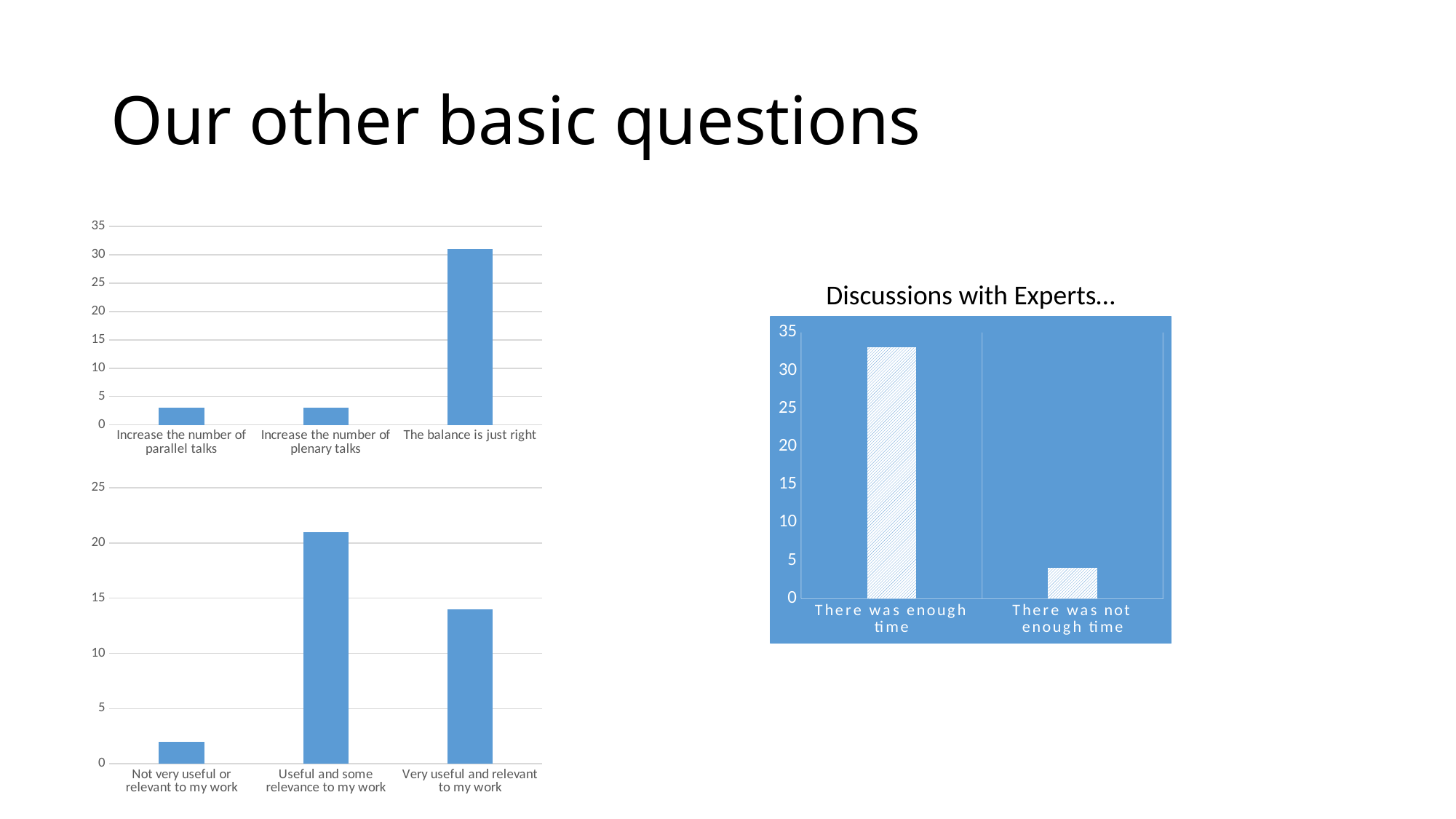
In the top-left chart, which category has the highest value? The balance is just right In the bottom-left chart, which category has the lowest value? Not very useful or relevant to my work In the bottom-left chart, which category has the highest value? Useful and some relevance to my work How many categories are shown in the 'Discussions with Experts...' chart? 2 What kind of chart is the 'Discussions with Experts...' chart? bar chart In the bottom-left chart, which is larger: 'Very useful and relevant to my work' or 'Not very useful or relevant to my work'? Very useful and relevant to my work In the 'Discussions with Experts...' chart, which category has the higher value? There was enough time In the top-left chart, is the value for 'Increase the number of parallel talks' greater or less than 5? less In the top-left chart, is the value for 'The balance is just right' greater or less than 30? greater In the bottom-left chart, is the value for 'Useful and some relevance to my work' greater or less than 20? greater How many categories are shown in the top-left chart? 3